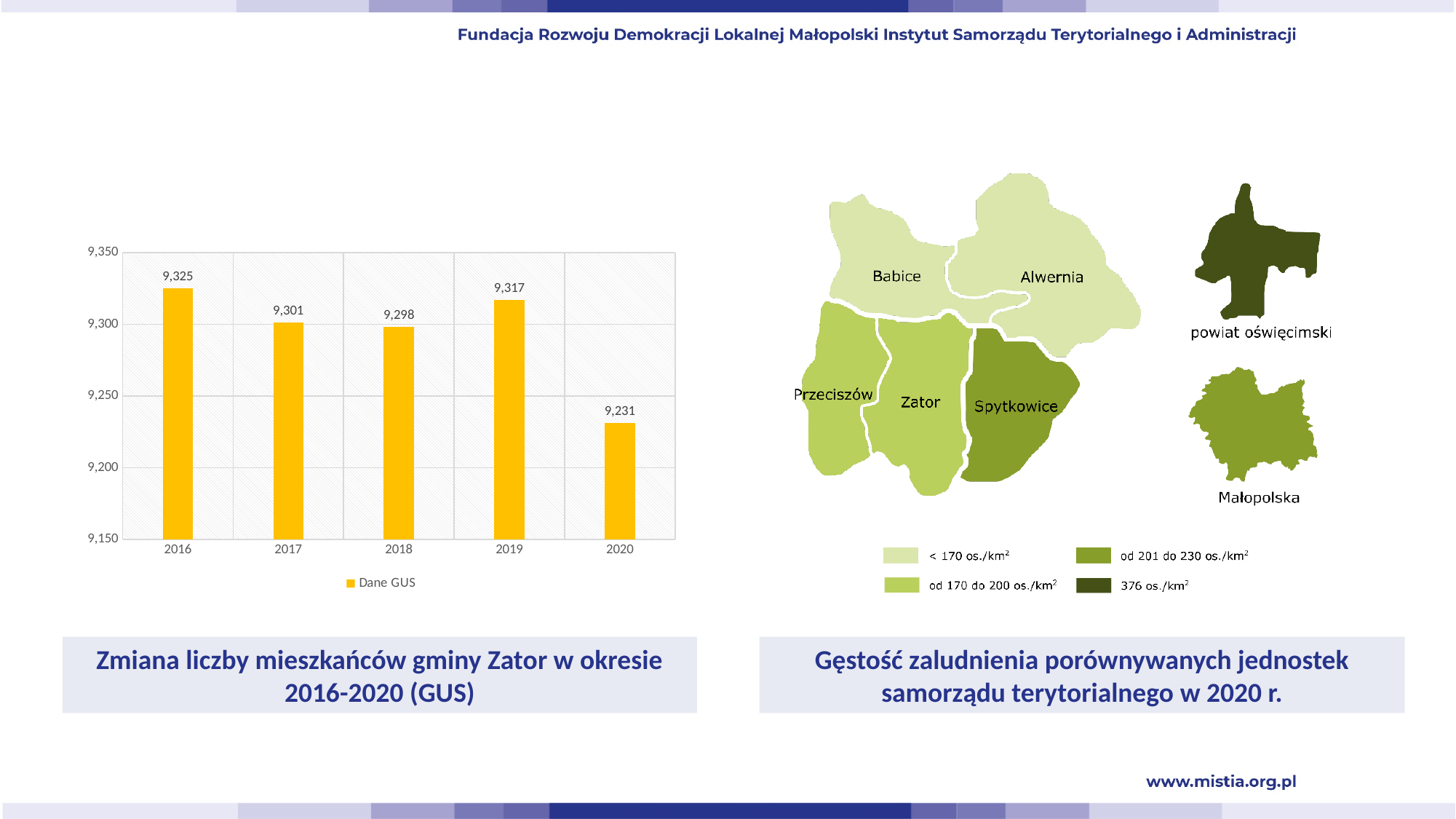
In the bar chart on the left, which year has the lowest value? 2020 In the bar chart on the left, what is the difference between the values for 2016 and 2017? 24 In the bar chart on the left, what is the difference between the values for 2019 and 2020? 86 What is the legend entry of the bar chart on the left? Dane GUS In the bar chart on the left, is the value for 2020 greater or less than 9,250? less In the bar chart on the left, what is the value for 2018? 9,298 In the bar chart on the left, what is the value for 2016? 9,325 In the bar chart on the left, which year has the highest value? 2016 What type of chart is shown on the left of the slide? bar chart How many years are shown in the bar chart on the left? 5 In the bar chart on the left, which is larger, the value for 2017 or the value for 2019? 2019 In the bar chart on the left, what is the value for 2020? 9,231